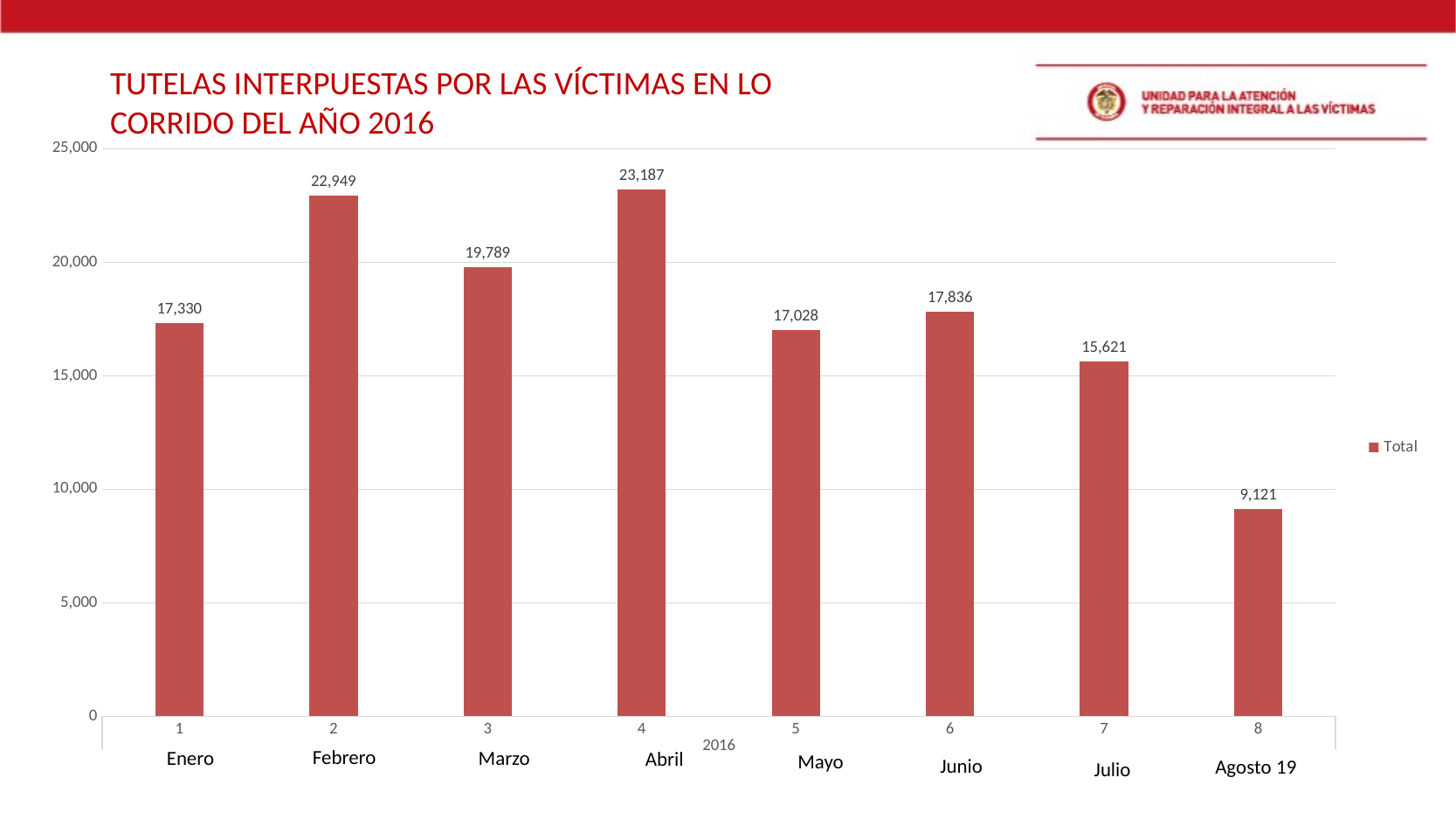
What is the value for Mayo? 17,028 What is the difference between the values for Marzo and Julio? 4,168 What is the difference between the values for Abril and Febrero? 238 Which month has the highest value? Abril What is the value for Febrero? 22,949 Which month has the lowest value? Agosto 19 What kind of chart is shown on the slide? bar chart Is the value for Julio greater or less than 15,000? greater How many months are shown on the chart? 8 What is the value for Agosto 19? 9,121 What is the only entry listed in the legend? Total Which is larger, the value for Enero or the value for Junio? Junio